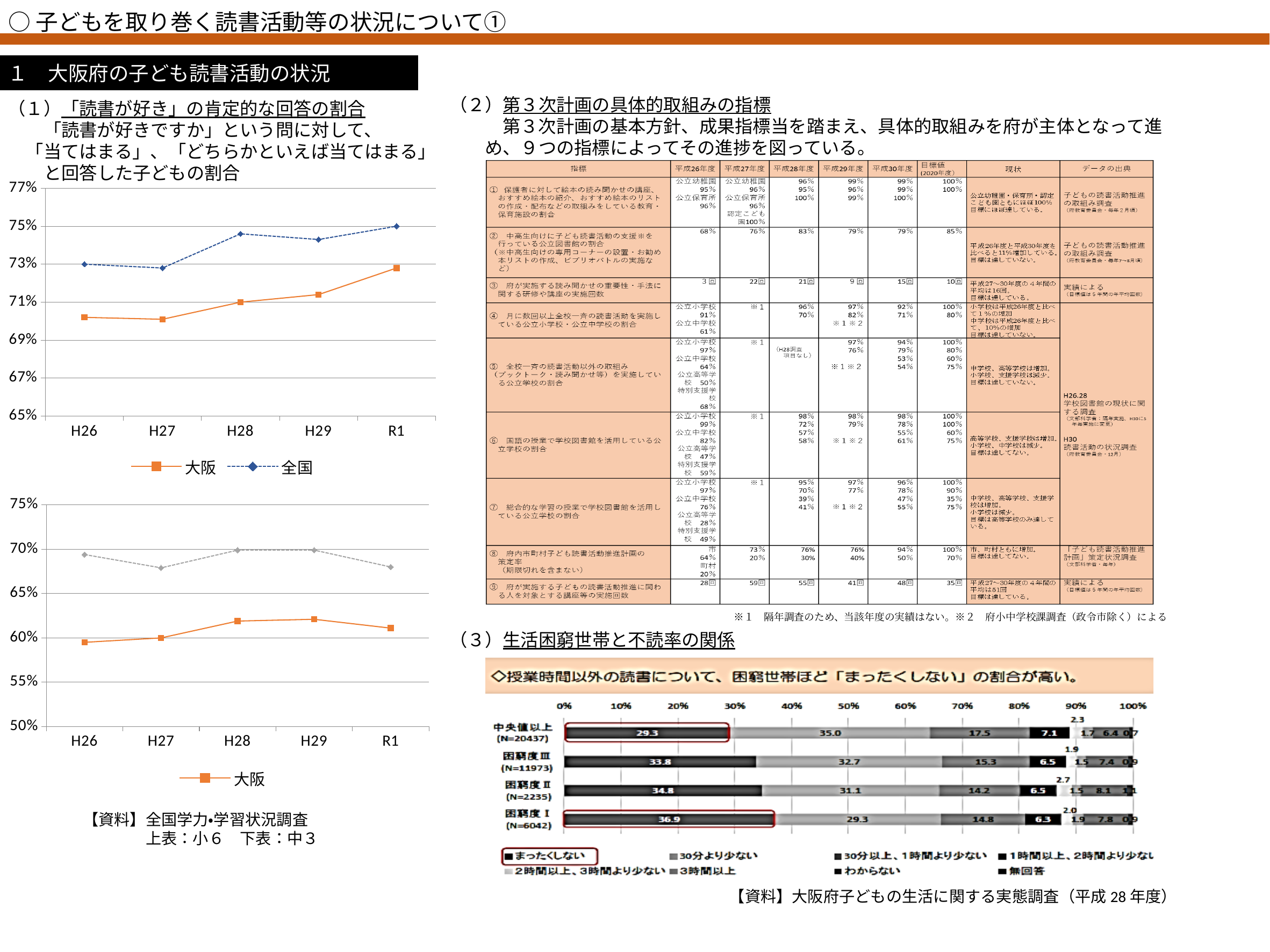
In the stacked bar chart at the bottom right (生活困窮世帯と不読率の関係), what is the まったくしない value for 困窮度Ⅰ? 36.9 In the stacked bar chart at the bottom right (生活困窮世帯と不読率の関係), how many entries does the legend list? 8 In the upper line chart on the left (小6), what kind of chart is it? line chart In the stacked bar chart at the bottom right (生活困窮世帯と不読率の関係), what is the difference in the まったくしない value between 困窮度Ⅰ and 中央値以上? 7.6 In the upper line chart on the left (小6), which is higher at R1, 大阪 or 全国? 全国 In the upper line chart on the left (小6), how many series does the legend list? 2 In the stacked bar chart at the bottom right (生活困窮世帯と不読率の関係), which category has the highest まったくしない share? 困窮度Ⅰ In the upper line chart on the left (小6), does the 大阪 line rise or fall overall from H26 to R1? rise In the lower line chart on the left (中3), is the value for 大阪 at H28 greater or less than 60%? greater In the upper line chart on the left (小6), how many year categories are on the x axis? 5 In the lower line chart on the left (中3), how many series does the legend list? 1 In the upper line chart on the left (小6), is the value for 大阪 at H26 greater or less than 71%? less